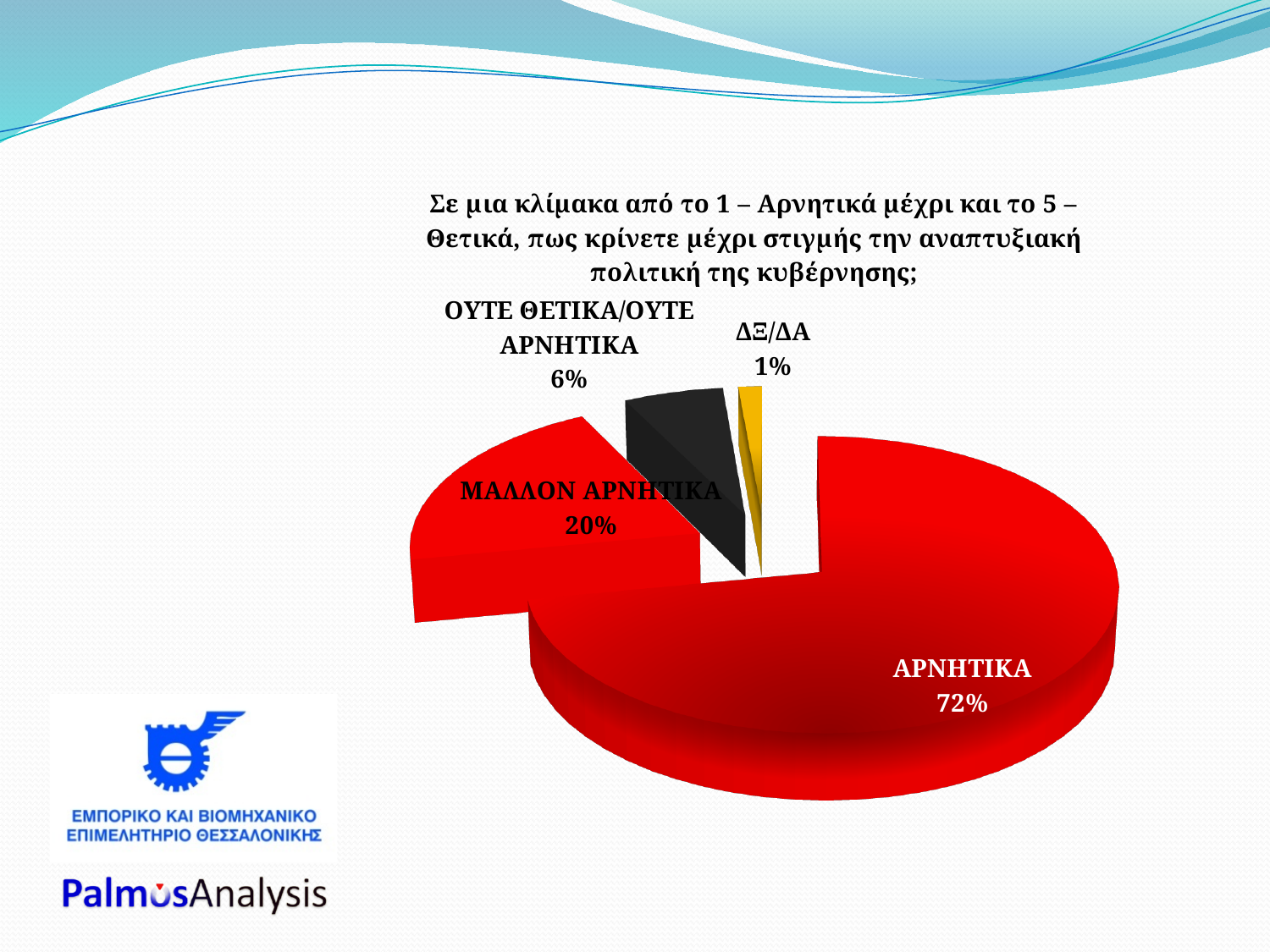
How many slices does the pie chart have? 4 What percentage of the pie chart is labelled ΑΡΝΗΤΙΚΑ? 72% What kind of chart is shown on the slide? Pie chart What is the combined share of ΑΡΝΗΤΙΚΑ and ΜΑΛΛΟΝ ΑΡΝΗΤΙΚΑ in the pie chart? 92% Which category has the smallest slice of the pie chart? ΔΞ/ΔΑ What percentage of the pie chart is labelled ΟΥΤΕ ΘΕΤΙΚΑ/ΟΥΤΕ ΑΡΝΗΤΙΚΑ? 6% What is the difference in percentage points between ΑΡΝΗΤΙΚΑ and ΜΑΛΛΟΝ ΑΡΝΗΤΙΚΑ? 52 Which category has the largest slice of the pie chart? ΑΡΝΗΤΙΚΑ What percentage of the pie chart is labelled ΜΑΛΛΟΝ ΑΡΝΗΤΙΚΑ? 20% What percentage of the pie chart is labelled ΔΞ/ΔΑ? 1% Which is larger, the share for ΜΑΛΛΟΝ ΑΡΝΗΤΙΚΑ or the share for ΟΥΤΕ ΘΕΤΙΚΑ/ΟΥΤΕ ΑΡΝΗΤΙΚΑ? ΜΑΛΛΟΝ ΑΡΝΗΤΙΚΑ What colour is the ΔΞ/ΔΑ slice of the pie chart? Yellow